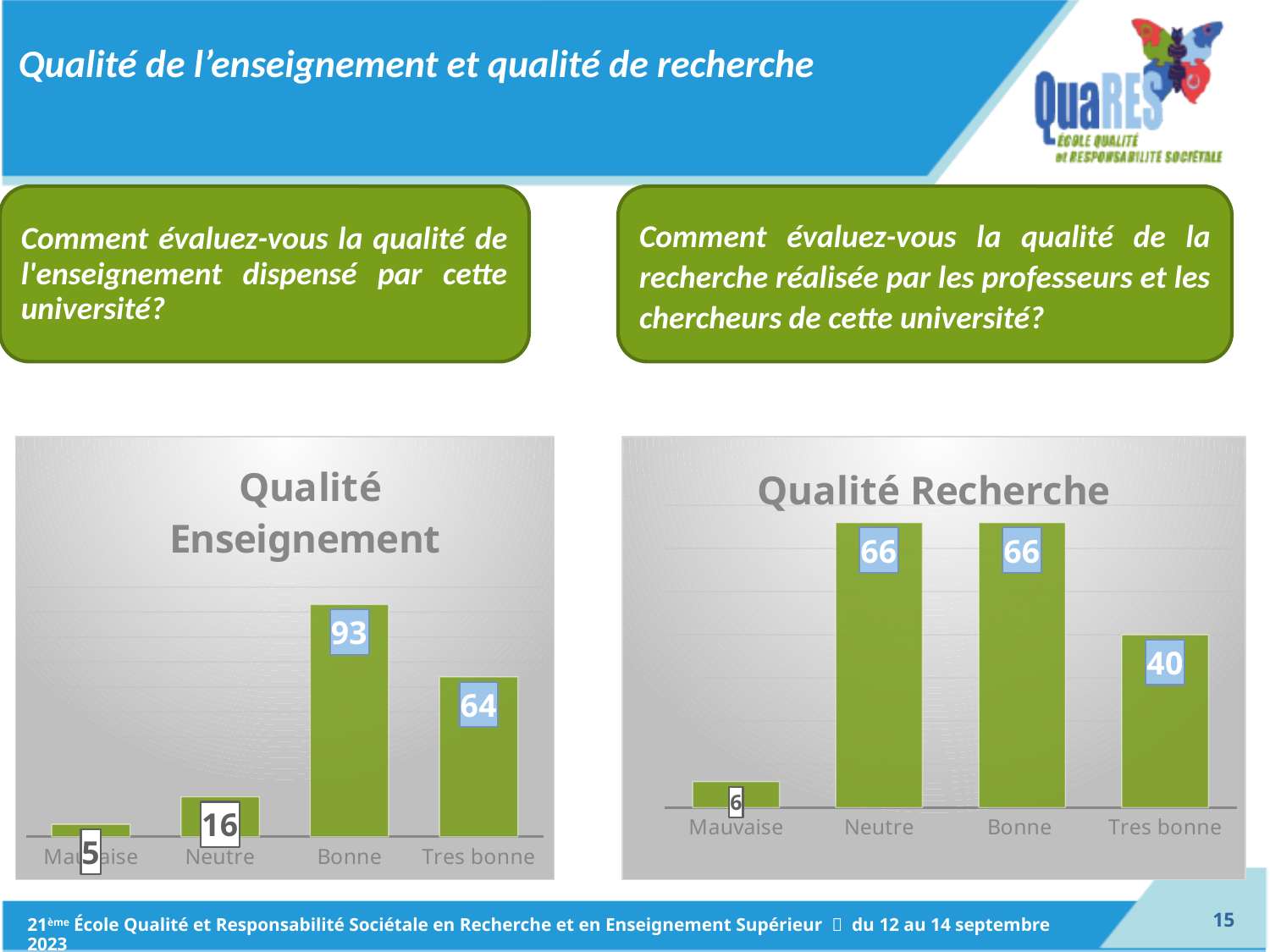
In the "Qualité Recherche" chart, what is the difference between the values for Neutre and Tres bonne? 26 In the "Qualité Recherche" chart, which category has the lowest value? Mauvaise How many categories are shown in the "Qualité Enseignement" chart? 4 In the "Qualité Enseignement" chart, what is the value for Neutre? 16 In the "Qualité Recherche" chart, which is larger, the value for Bonne or the value for Tres bonne? Bonne In the "Qualité Enseignement" chart, which category has the highest value? Bonne In the "Qualité Enseignement" chart, what is the difference between the values for Bonne and Tres bonne? 29 In the "Qualité Recherche" chart, what is the value for Tres bonne? 40 In the "Qualité Enseignement" chart, what is the value for Bonne? 93 What type of chart is the "Qualité Recherche" chart? Bar chart In the "Qualité Recherche" chart, what is the value for Mauvaise? 6 In the "Qualité Enseignement" chart, which category has the lowest value? Mauvaise